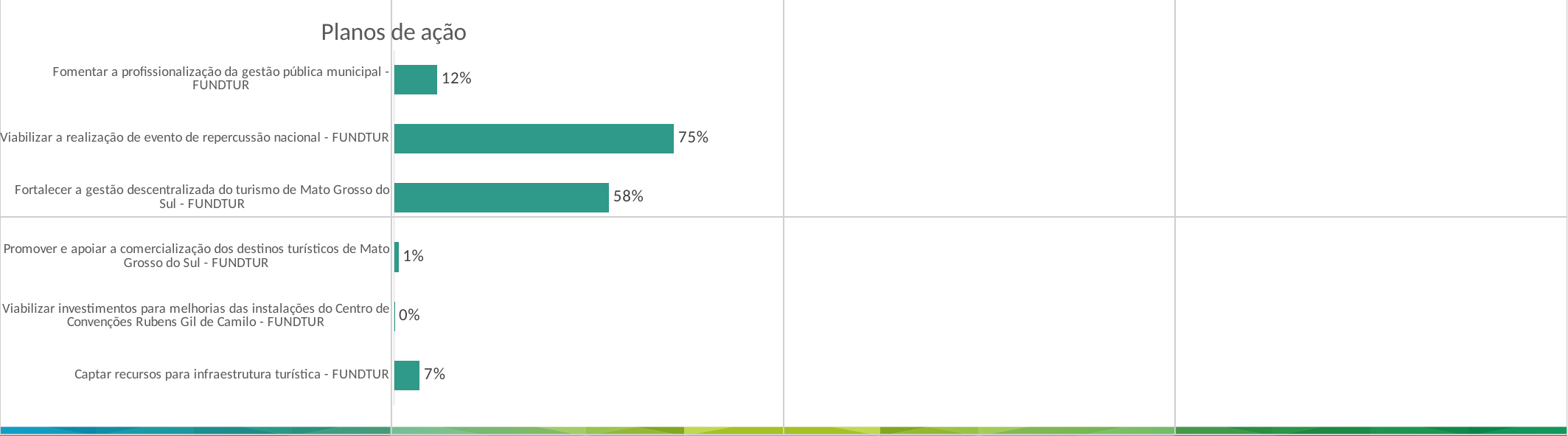
Which is larger: the value for 'Fomentar a profissionalização da gestão pública municipal - FUNDTUR' or for 'Captar recursos para infraestrutura turística - FUNDTUR'? Fomentar a profissionalização da gestão pública municipal - FUNDTUR What is the title of the chart? Planos de ação What is the value for 'Viabilizar a realização de evento de repercussão nacional - FUNDTUR'? 75% What is the difference between the values for 'Viabilizar a realização de evento de repercussão nacional - FUNDTUR' and 'Fortalecer a gestão descentralizada do turismo de Mato Grosso do Sul - FUNDTUR'? 17% What is the value for 'Fomentar a profissionalização da gestão pública municipal - FUNDTUR'? 12% What is the value for 'Promover e apoiar a comercialização dos destinos turísticos de Mato Grosso do Sul - FUNDTUR'? 1% Which category has the lowest value? Viabilizar investimentos para melhorias das instalações do Centro de Convenções Rubens Gil de Camilo - FUNDTUR What is the value for 'Captar recursos para infraestrutura turística - FUNDTUR'? 7% What kind of chart is shown on the slide? Bar chart How many categories are shown in the chart? 6 Which category has the highest value? Viabilizar a realização de evento de repercussão nacional - FUNDTUR What is the value for 'Viabilizar investimentos para melhorias das instalações do Centro de Convenções Rubens Gil de Camilo - FUNDTUR'? 0%